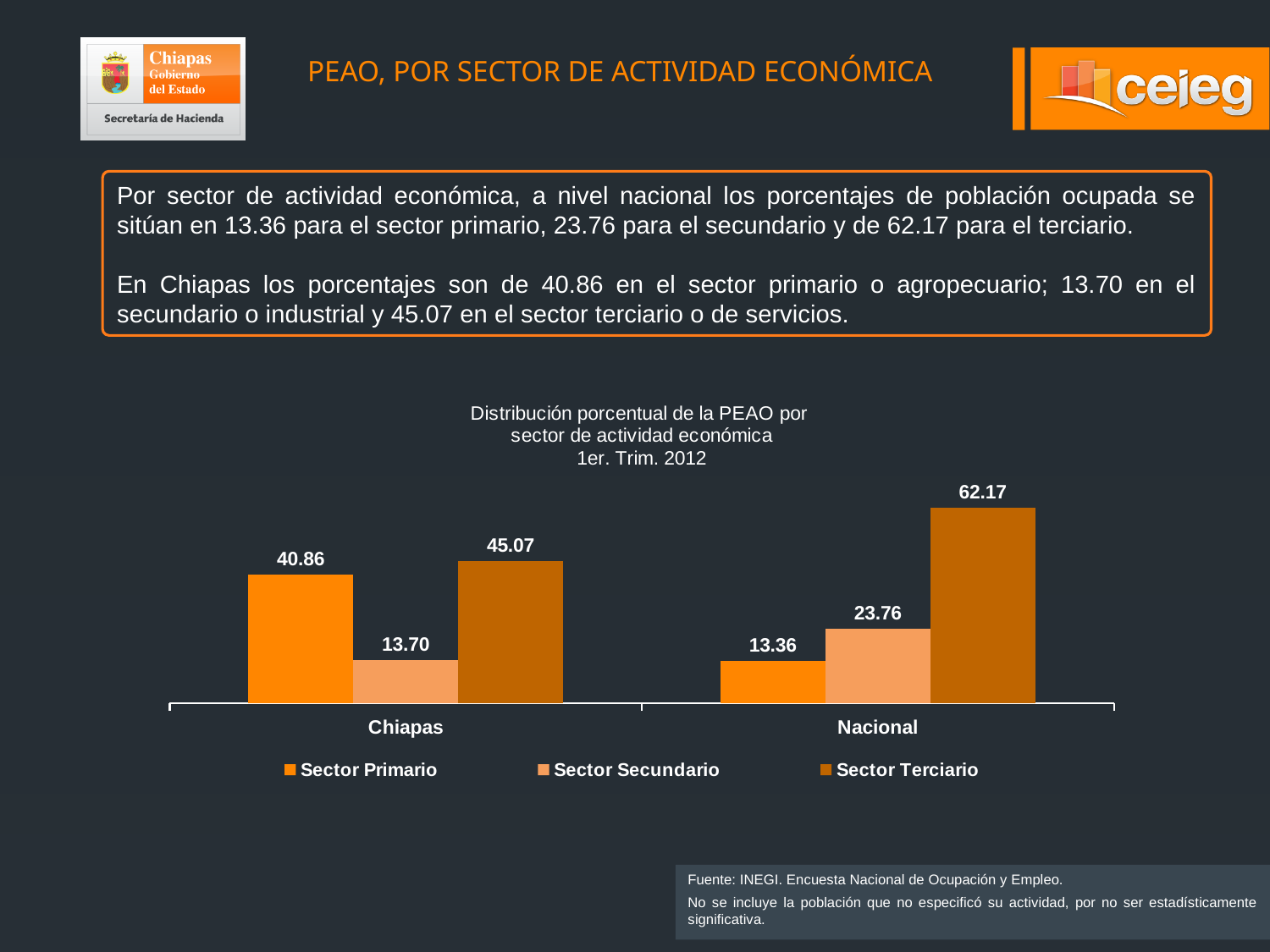
What is the value for Sector Secundario in Chiapas? 13.70 How many categories are shown on the x axis? 2 Which sector has the highest value for Nacional? Sector Terciario What is the value for Sector Primario in Chiapas? 40.86 Which is larger: Sector Secundario in Chiapas or Sector Secundario for Nacional? Nacional What is the title of the chart? Distribución porcentual de la PEAO por sector de actividad económica 1er. Trim. 2012 What is the difference between Sector Terciario and Sector Primario in Chiapas? 4.21 Which sector has the lowest value in Chiapas? Sector Secundario What type of chart is shown? Bar chart What is the difference between the Sector Primario values for Chiapas and Nacional? 27.50 How many series does the legend list? 3 What is the value for Sector Terciario for Nacional? 62.17